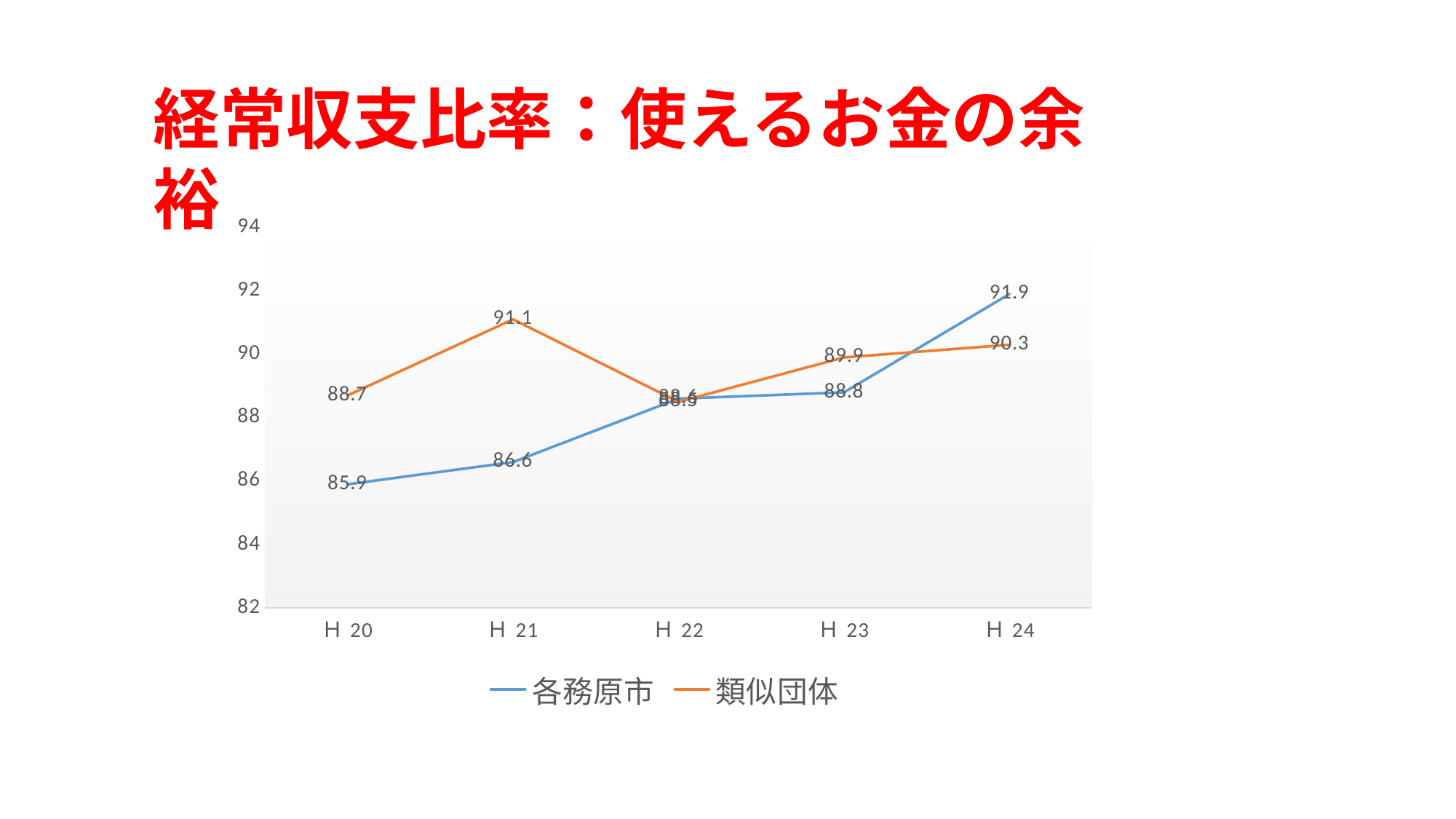
How many series does the legend list? 2 What is the value for 各務原市 in H 20? 85.9 What is the difference between 各務原市 and 類似団体 in H 24? 1.6 What is the value for 類似団体 in H 24? 90.3 How many years are plotted along the x axis? 5 In which year is the value for 各務原市 highest? H 24 What kind of chart is shown on the slide? line chart What is the value for 類似団体 in H 23? 89.9 In H 21, which series has the larger value, 各務原市 or 類似団体? 類似団体 Does the value for 各務原市 rise or fall from H 20 to H 24? rise What is the value for 各務原市 in H 24? 91.9 What is the value for 類似団体 in H 21? 91.1